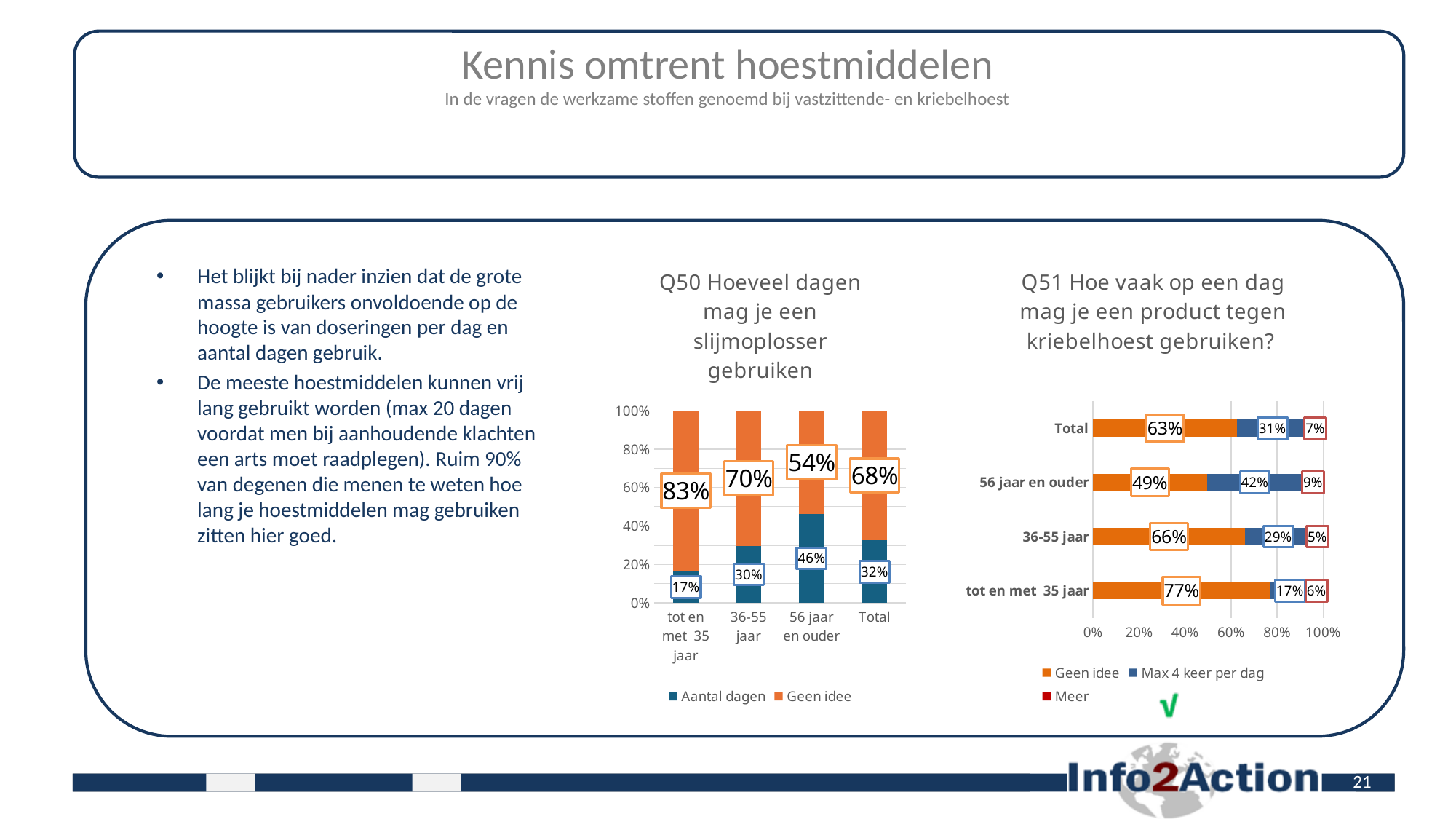
In the Q51 chart, what is the 'Max 4 keer per dag' value for '56 jaar en ouder'? 42% In the Q51 chart, how many categories are shown on the vertical axis? 4 In the Q51 chart, is the 'Geen idee' value for '36-55 jaar' larger than that for 'Total'? Yes In the Q50 chart, what is the difference between the 'Geen idee' values for 'tot en met 35 jaar' and '36-55 jaar'? 13% In the Q50 chart, what is the 'Aantal dagen' value for 'tot en met 35 jaar'? 17% In the Q51 chart, how many series does the legend list? 3 In the Q51 chart, which category has the lowest 'Geen idee' value? 56 jaar en ouder In the Q50 chart, what is the 'Geen idee' value for '56 jaar en ouder'? 54% In the Q50 chart, which category has the highest 'Aantal dagen' value? 56 jaar en ouder What kind of chart is the Q50 chart? Stacked bar chart In the Q51 chart, what is the 'Meer' value for 'Total'? 7% In the Q50 chart, how many series does the legend list? 2